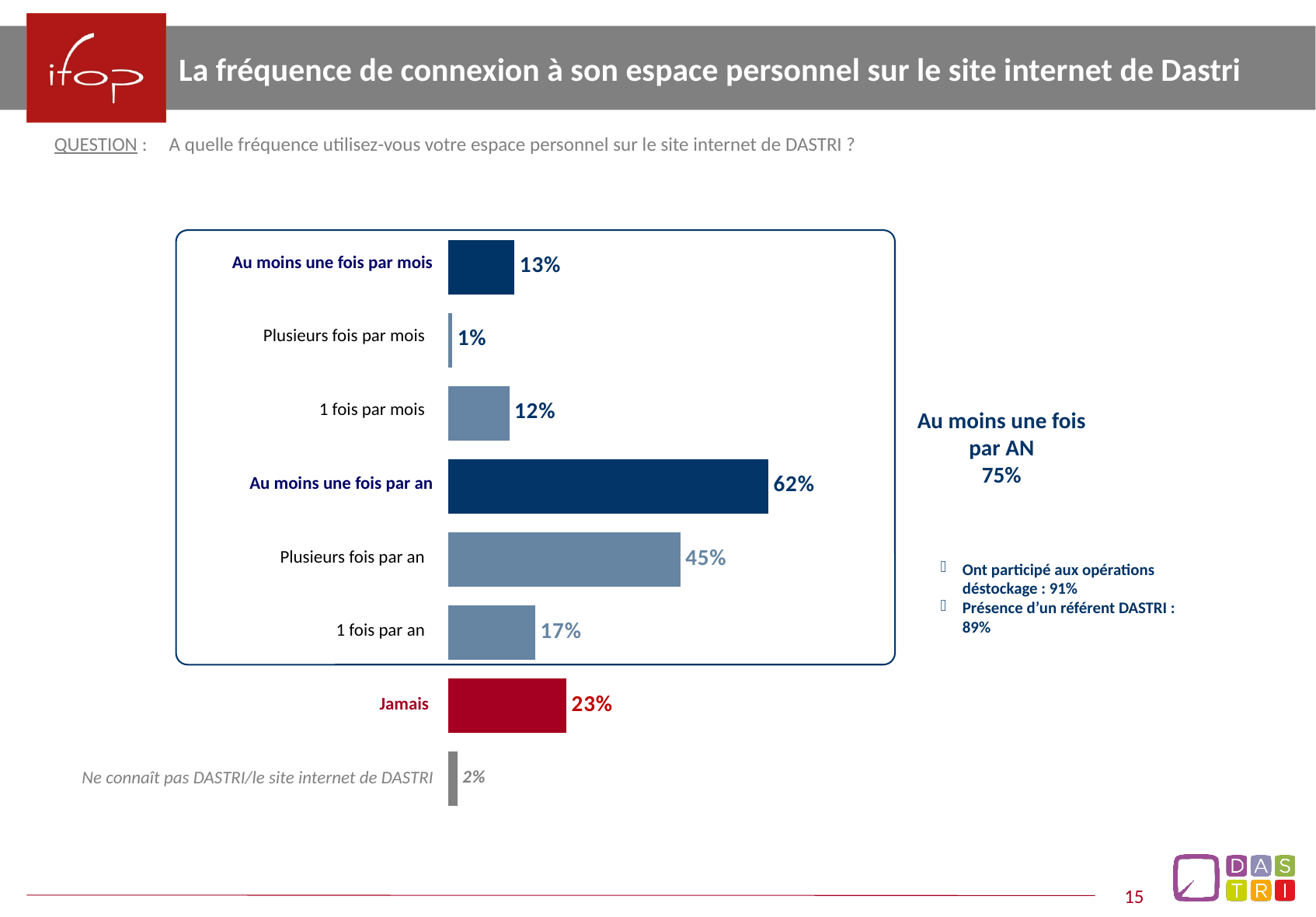
What is the difference between "Au moins une fois par mois" and "1 fois par mois"? 1% How many bars are shown in the chart? 8 Which category has the lowest value? Plusieurs fois par mois Which is larger, "Au moins une fois par mois" or "Jamais"? Jamais What is the difference between "Plusieurs fois par an" and "1 fois par an"? 28% What is the value for "Jamais"? 23% What kind of chart is shown on the slide? Bar chart What is the value for "Ne connaît pas DASTRI/le site internet de DASTRI"? 2% What is the value for "Au moins une fois par an"? 62% What percentage is given for "Au moins une fois par AN" in the text to the right of the chart? 75% Which category has the highest value? Au moins une fois par an What is the value for "Plusieurs fois par an"? 45%